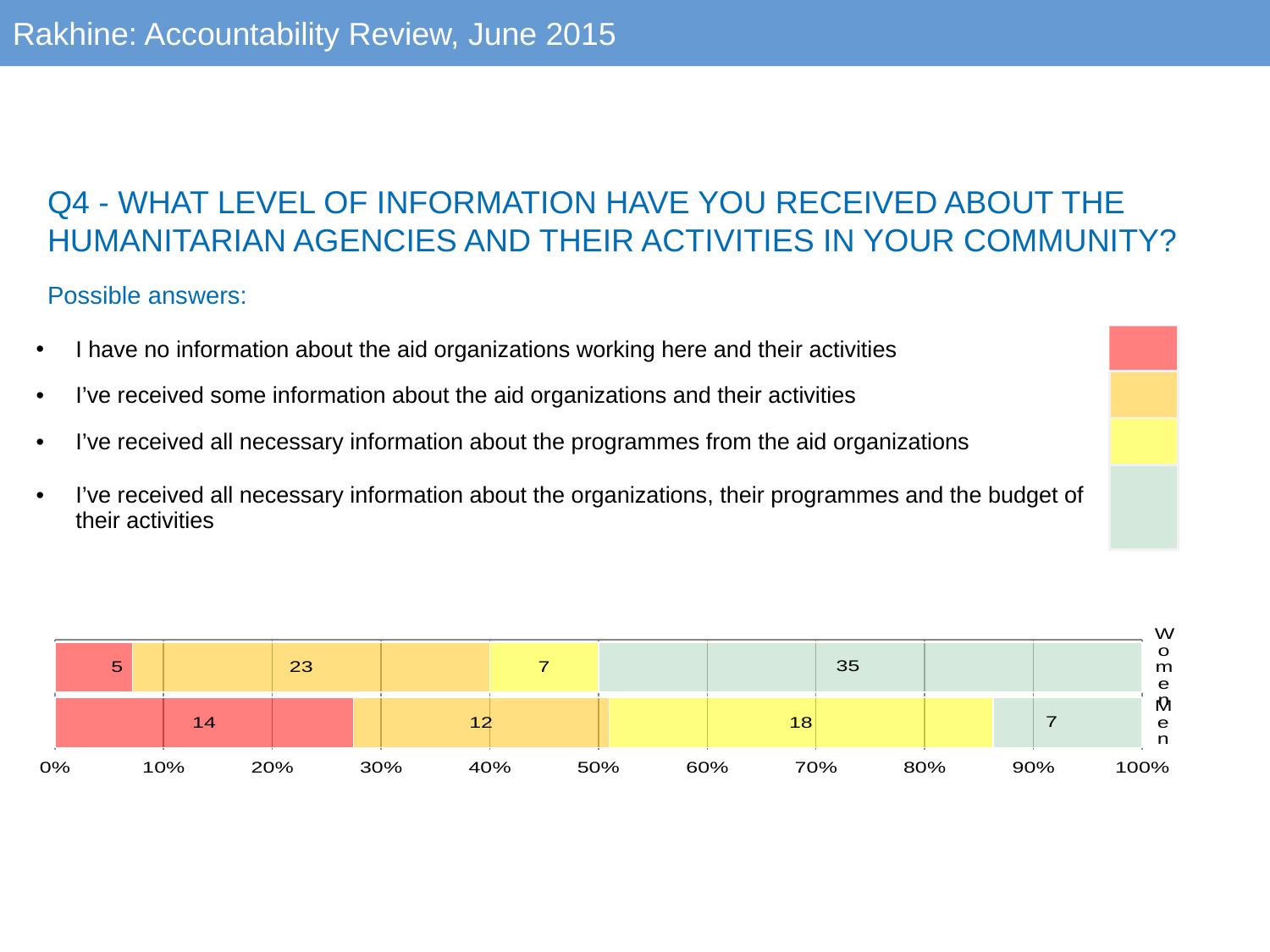
How many coloured segments (series) make up each bar? 4 What is the value of the red segment in the Men bar? 14 What is the value of the green segment (all necessary information including budget) in the Women bar? 35 What is the smallest value shown in the Men bar? 7 What kind of chart is shown on the slide? Stacked bar chart What is the total of the values in the Women bar (5 + 23 + 7 + 35)? 70 Which bar has the larger red segment value, Women or Men? Men Which segment has the largest value in the Women bar? 35 (green segment) How many bars (categories) does the chart show? 2 What is the difference between the green segment values for Women (35) and Men (7)? 28 What is the value of the red segment (no information) in the Women bar? 5 What is the value of the yellow segment in the Men bar? 18